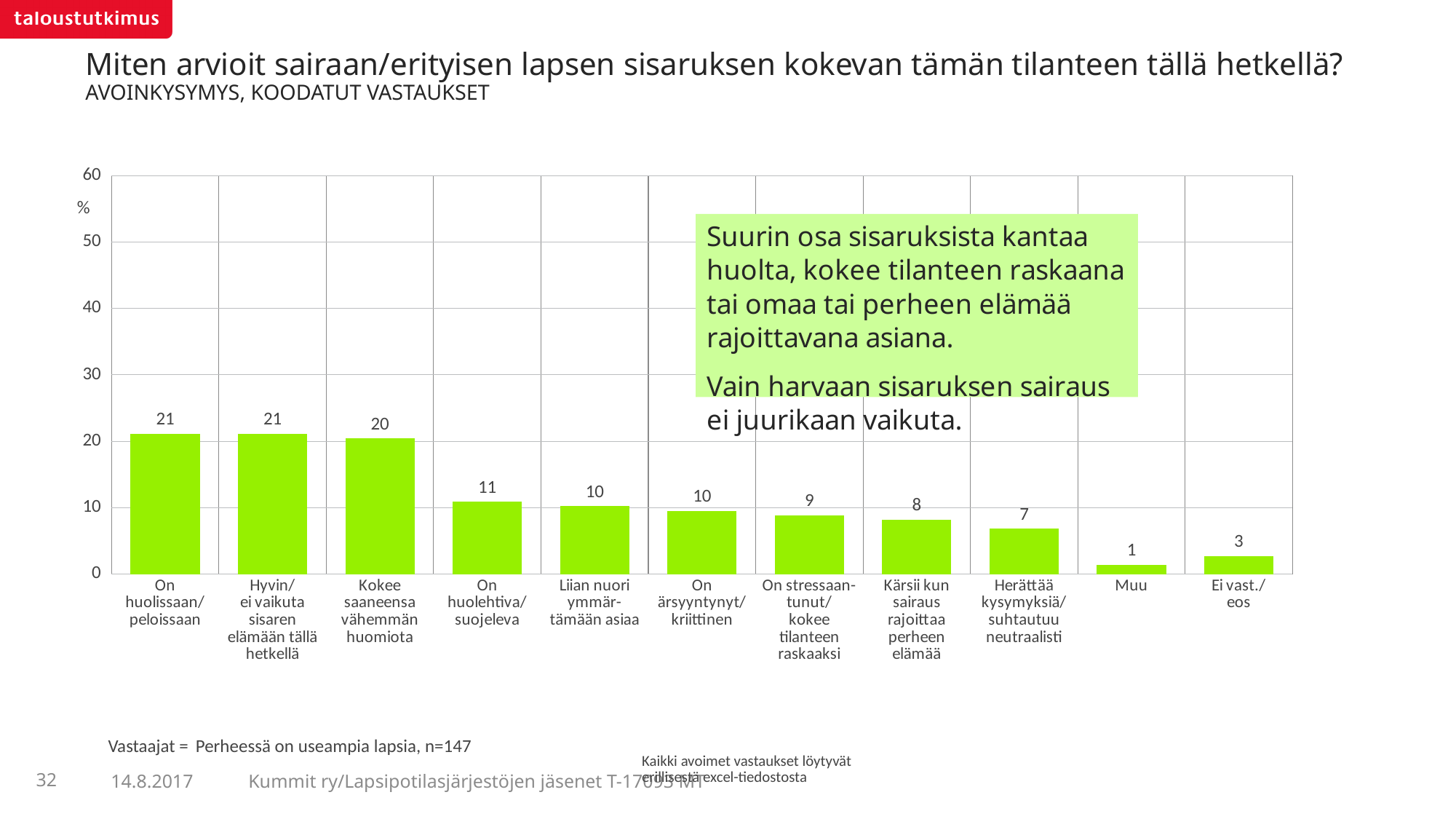
Which is larger, the value for "On stressaantunut/kokee tilanteen raskaaksi" or the value for "Kärsii kun sairaus rajoittaa perheen elämää"? On stressaantunut/kokee tilanteen raskaaksi What is the value for "Kokee saaneensa vähemmän huomiota"? 20 What is the value for "Muu"? 1 What kind of chart is shown on the slide? bar chart Which category has the lowest value? Muu What is the value for "Ei vast./eos"? 3 Is the value for "Liian nuori ymmärtämään asiaa" greater or less than 20? less How many categories are plotted on the chart? 11 What unit is shown on the y axis of the chart? % What is the value for "On huolehtiva/suojeleva"? 11 Do the values generally rise or fall from left to right along the x axis? fall What is the difference between the values for "On huolissaan/peloissaan" and "Herättää kysymyksiä/suhtautuu neutraalisti"? 14